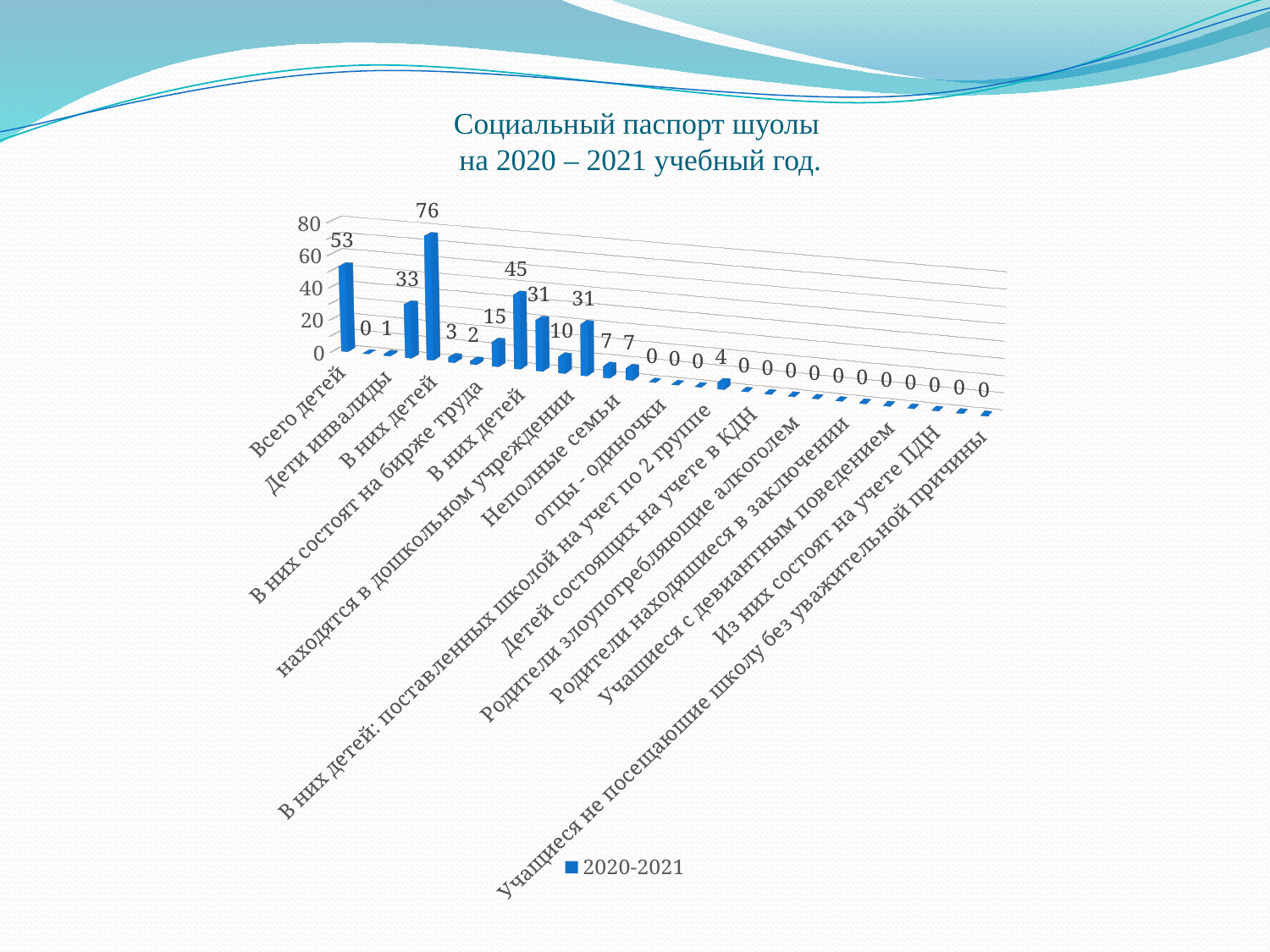
What is the difference between the highest bar value (76) and the value for Всего детей (53)? 23 How many series does the legend list? 1 What is the highest value shown by any bar in the chart? 76 What is the highest tick value on the vertical axis? 80 Which is larger: the value for Всего детей or the highest bar value of 76? 76 Is the value for Всего детей greater or less than 40? greater What is the lowest value shown by any bar in the chart? 0 What is the title of the chart? Социальный паспорт шуолы на 2020 – 2021 учебный год. What is the legend entry of the chart? 2020-2021 What kind of chart is shown on the slide? bar chart What is the value for Всего детей? 53